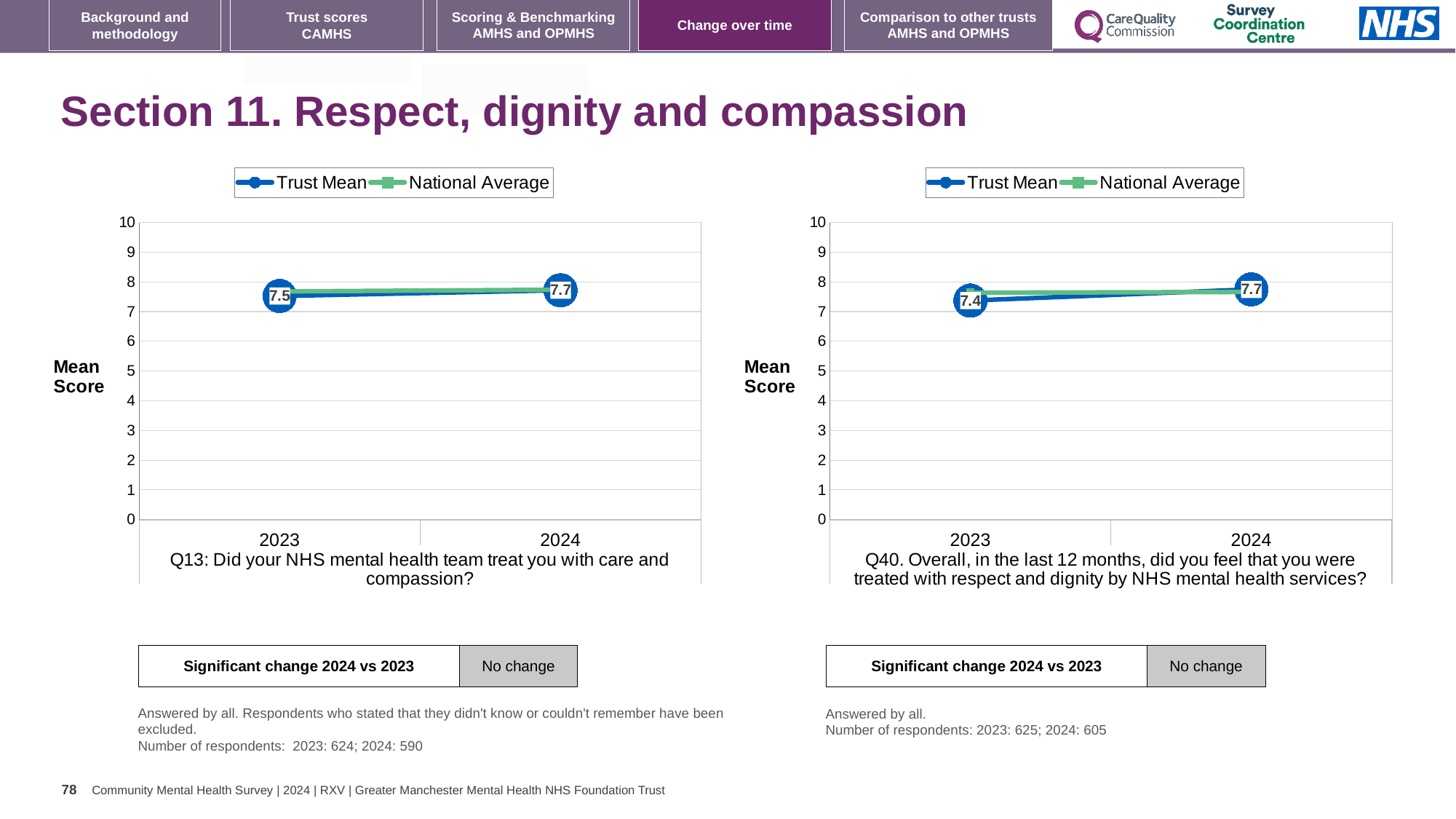
How many series does the legend of the left chart (Q13) list? 2 In the right chart (Q40), what is the Trust Mean for 2024? 7.7 In the left chart (Q13), does the Trust Mean rise or fall from 2023 to 2024? rise What kind of chart is the right chart (Q40)? line chart In the right chart (Q40), is the National Average for 2023 greater or less than 5? greater How many years are plotted on the x axis of the right chart (Q40)? 2 In the left chart (Q13), by how much did the Trust Mean change from 2023 to 2024? 0.2 In the left chart (Q13), what is the Trust Mean for 2023? 7.5 In the right chart (Q40), by how much did the Trust Mean change from 2023 to 2024? 0.3 In the right chart (Q40), what is the Trust Mean for 2023? 7.4 What are the two series named in the legend of the right chart (Q40)? Trust Mean and National Average In the left chart (Q13), what is the Trust Mean for 2024? 7.7